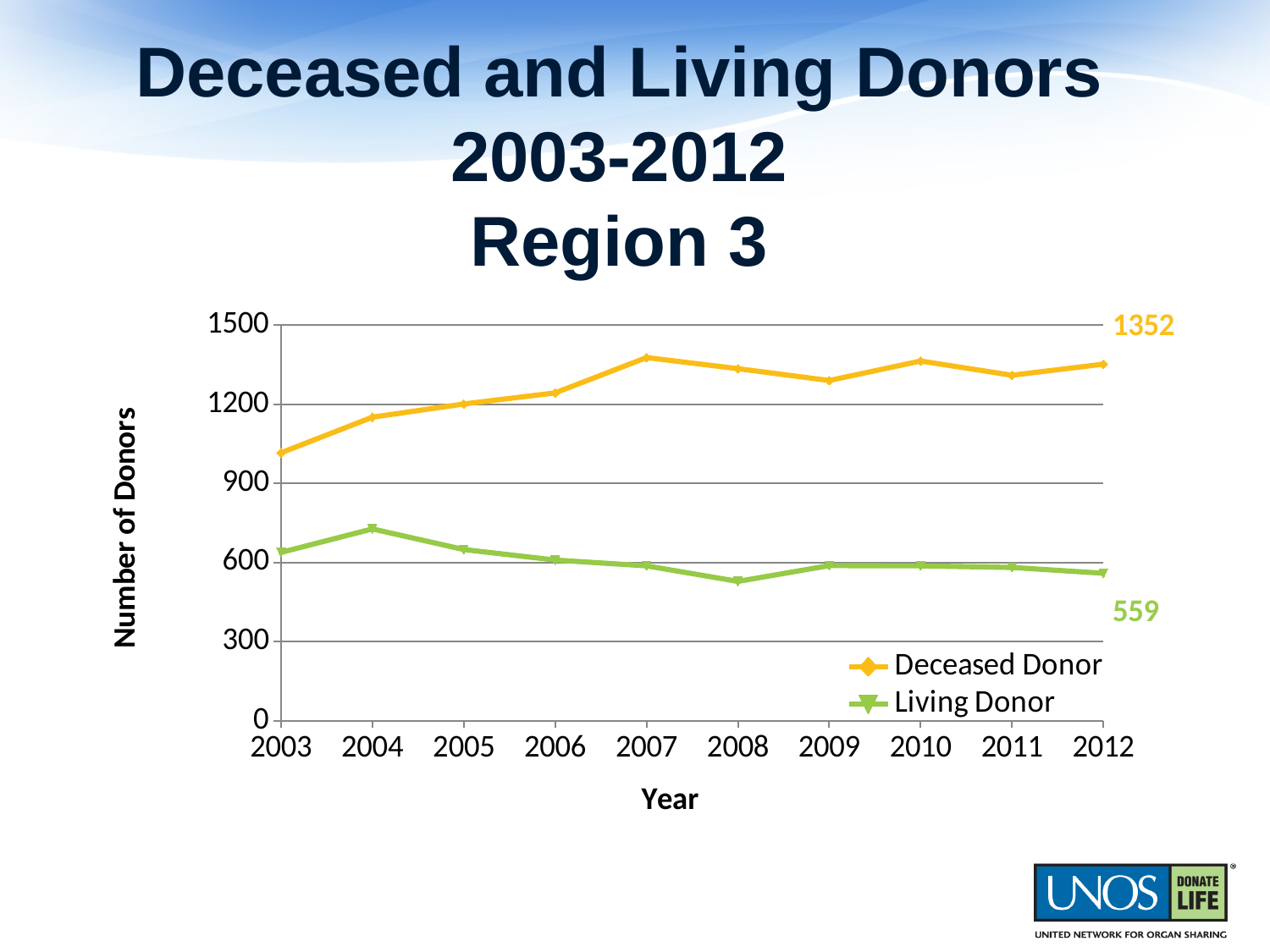
What is the difference between the Deceased Donor and Living Donor values in 2012? 793 Which series has the larger value in 2012, Deceased Donor or Living Donor? Deceased Donor What is the title of the vertical axis? Number of Donors What kind of chart is shown on the slide? Line chart In which year is the Living Donor value highest? 2004 How many years are plotted along the x axis? 10 Is the value for Living Donor in 2004 greater or less than 600? greater What is the value for Deceased Donor in 2012? 1352 Is the value for Deceased Donor in 2003 greater or less than 1200? less In which year is the Deceased Donor value lowest? 2003 How many series does the legend list? 2 What is the value for Living Donor in 2012? 559